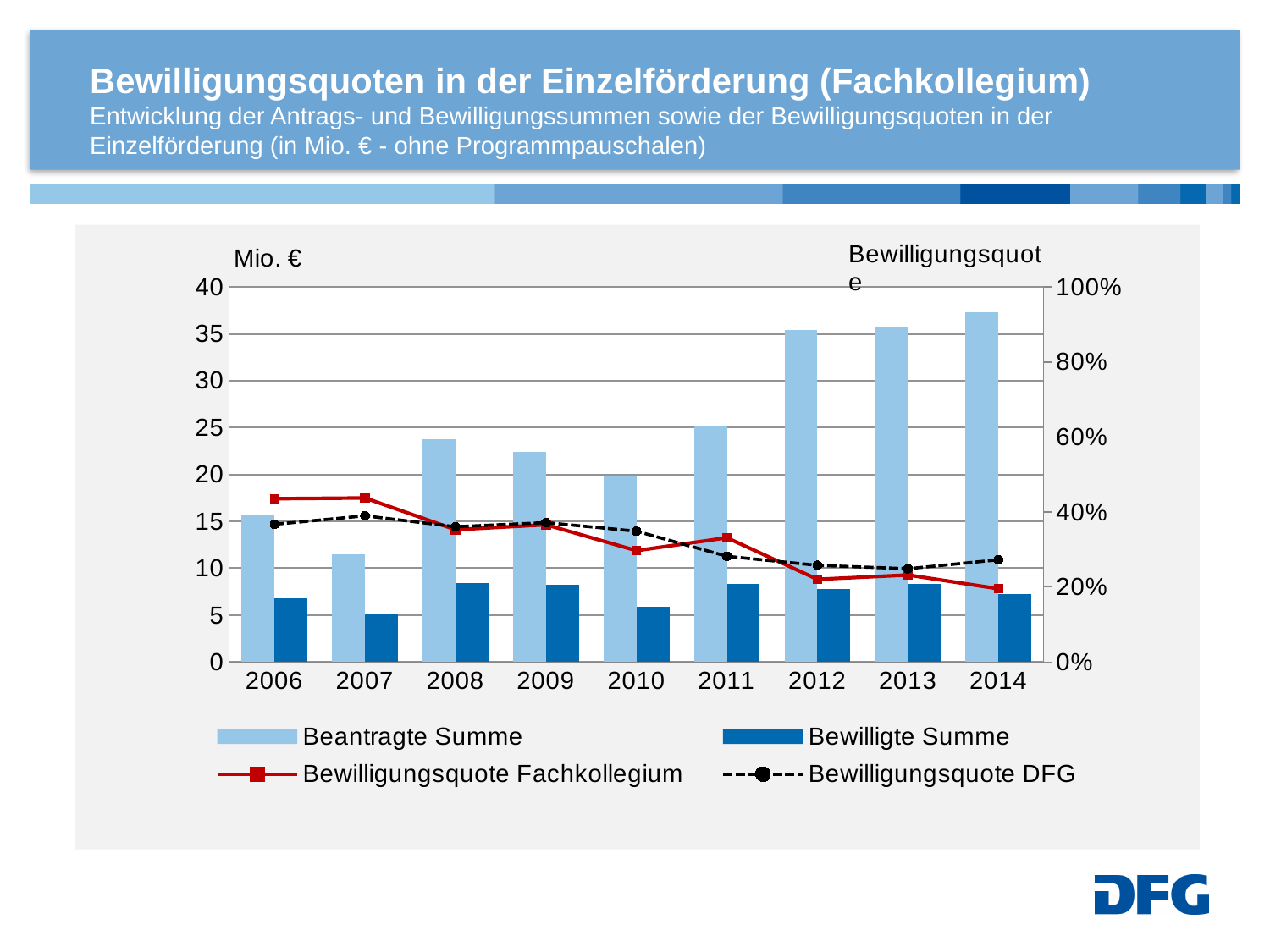
In which year is the Bewilligte Summe lowest? 2007 Is the Beantragte Summe for 2012 greater or less than 30 Mio. €? greater In which year is the Beantragte Summe lowest? 2007 What kind of chart is shown on the slide? Combined bar and line chart Is the Bewilligungsquote DFG for 2014 greater or less than 20%? greater In which year is the Beantragte Summe highest? 2014 In 2014, which is higher: the Bewilligungsquote Fachkollegium or the Bewilligungsquote DFG? Bewilligungsquote DFG Is the Bewilligungsquote Fachkollegium for 2006 greater or less than 40%? greater How many years are shown on the x axis of the chart? 9 Does the Bewilligungsquote Fachkollegium generally rise or fall from 2006 to 2014? fall In which year is the Bewilligungsquote Fachkollegium lowest? 2014 How many series does the chart legend list? 4